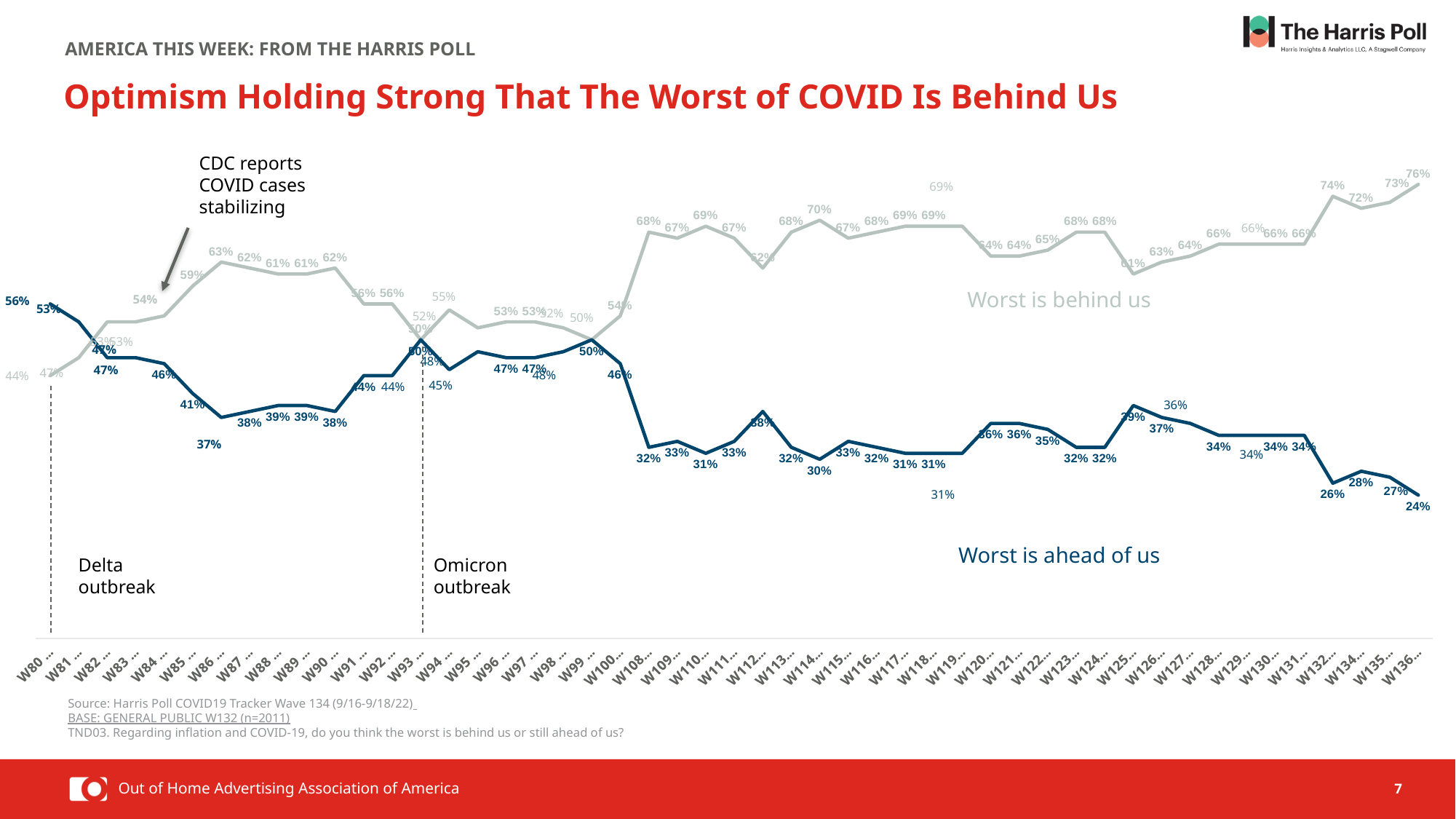
At which wave does the 'Worst is ahead of us' series reach its lowest value? W136 Does the 'Worst is ahead of us' series generally rise or fall from W80 to W136? fall What is the difference between the 'Worst is behind us' and 'Worst is ahead of us' values at W136? 52 percentage points What is the value of the 'Worst is behind us' series at W136? 76% What is the value of the 'Worst is ahead of us' series at W80? 56% What is the value of the 'Worst is ahead of us' series at W136? 24% What kind of chart is shown on the slide? line chart What two outbreaks are marked with dashed vertical lines on the chart? Delta outbreak and Omicron outbreak At W132, which series has the larger value, 'Worst is behind us' or 'Worst is ahead of us'? Worst is behind us What is the value of the 'Worst is behind us' series at W86? 63% At which wave does the 'Worst is behind us' series reach its highest value? W136 How many series are plotted on the chart? 2